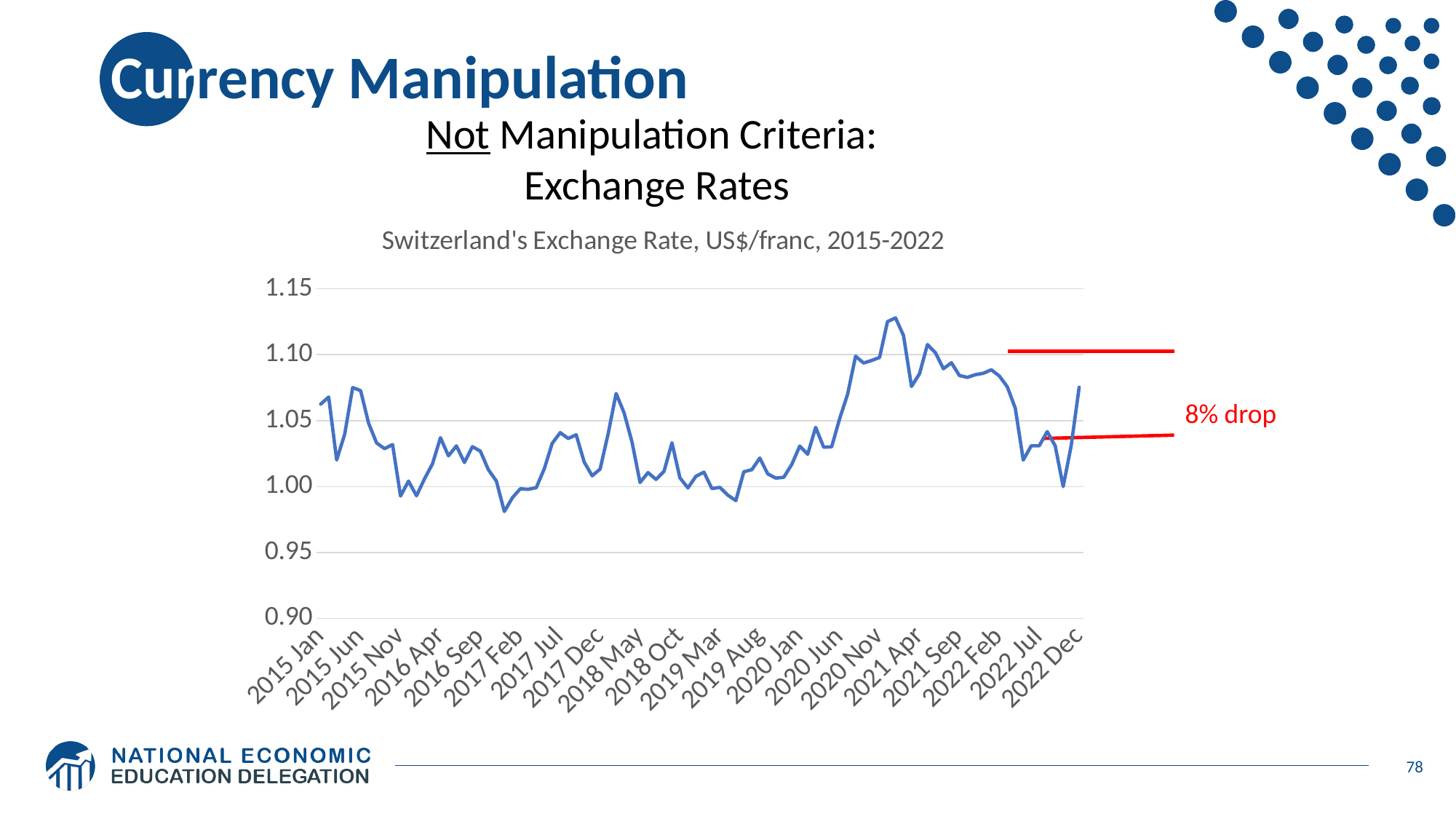
What is the title of the chart? Switzerland's Exchange Rate, US$/franc, 2015-2022 What kind of chart is shown on the slide? line chart What does the red annotation next to the chart say? 8% drop Is the exchange rate at 2015 Jan greater or less than 1.00? greater Which is higher, the exchange rate at 2015 Jan or at 2017 Feb? 2015 Jan What is the highest value shown on the y axis? 1.15 How many month labels are shown on the x axis? 20 Is the exchange rate at 2016 Sep greater or less than 1.00? greater Near which labeled month does the line reach its lowest value? 2017 Feb Is the exchange rate at 2022 Dec greater or less than 1.05? greater Does the exchange rate rise or fall between 2020 Jan and 2020 Nov? rise